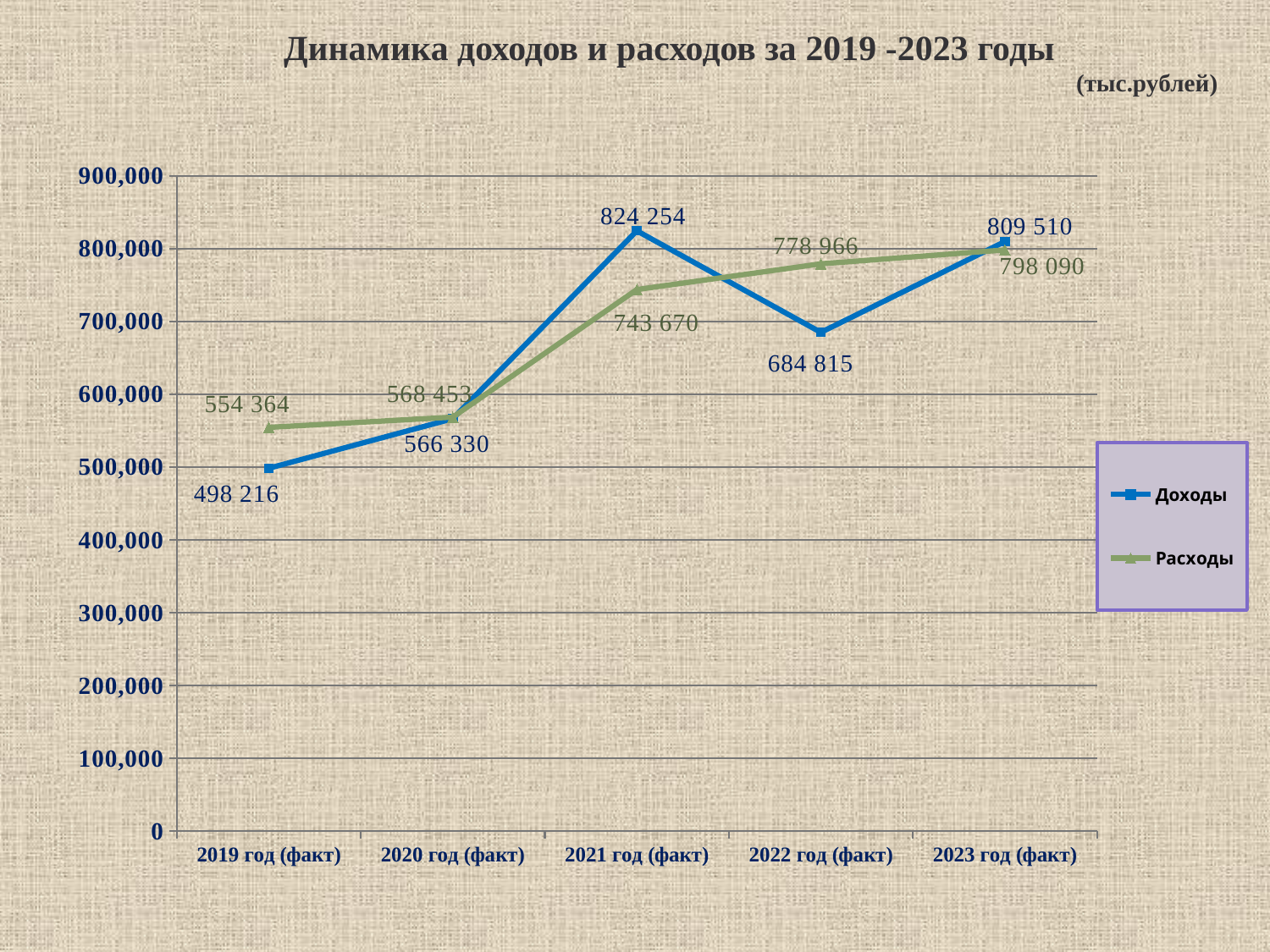
What is the value of Расходы for 2023 год (факт)? 798 090 What is the value of Доходы for 2022 год (факт)? 684 815 In which year is Расходы lowest? 2019 год (факт) Does Расходы rise or fall from 2019 to 2023? Rise How many years are shown on the x axis? 5 What is the difference between Доходы and Расходы in 2021 год (факт)? 80 584 Which is larger in 2022 год (факт), Доходы or Расходы? Расходы In which year is Доходы highest? 2021 год (факт) What is the value of Расходы for 2019 год (факт)? 554 364 What kind of chart is shown on the slide? Line chart How many series does the legend list? 2 What is the value of Доходы for 2021 год (факт)? 824 254